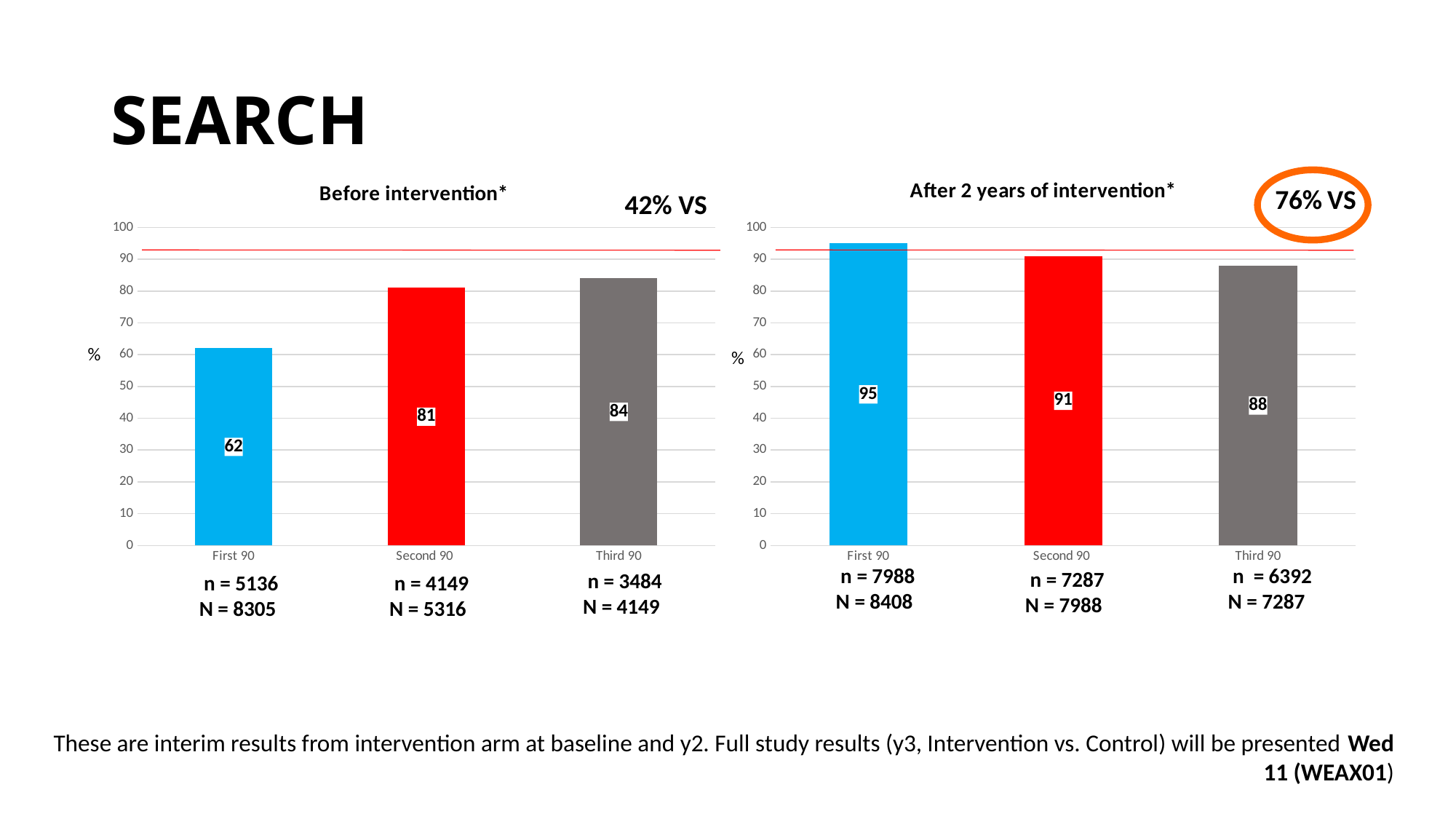
In the 'After 2 years of intervention*' chart, which category has the lowest value? Third 90 In the 'Before intervention*' chart, which is larger, the value for Second 90 or the value for Third 90? Third 90 In the 'After 2 years of intervention*' chart, what is the value for Third 90? 88 What kind of chart is the 'Before intervention*' chart? Bar chart How many categories are shown in the 'After 2 years of intervention*' chart? 3 In the 'Before intervention*' chart, what is the value for Second 90? 81 In the 'After 2 years of intervention*' chart, what is the value for First 90? 95 In the 'Before intervention*' chart, what is the difference between the values for Third 90 and First 90? 22 In the 'After 2 years of intervention*' chart, do the values rise or fall from First 90 to Third 90? Fall In the 'Before intervention*' chart, which category has the highest value? Third 90 In the 'Before intervention*' chart, what is the value for First 90? 62 In the 'After 2 years of intervention*' chart, what is the difference between the values for First 90 and Second 90? 4